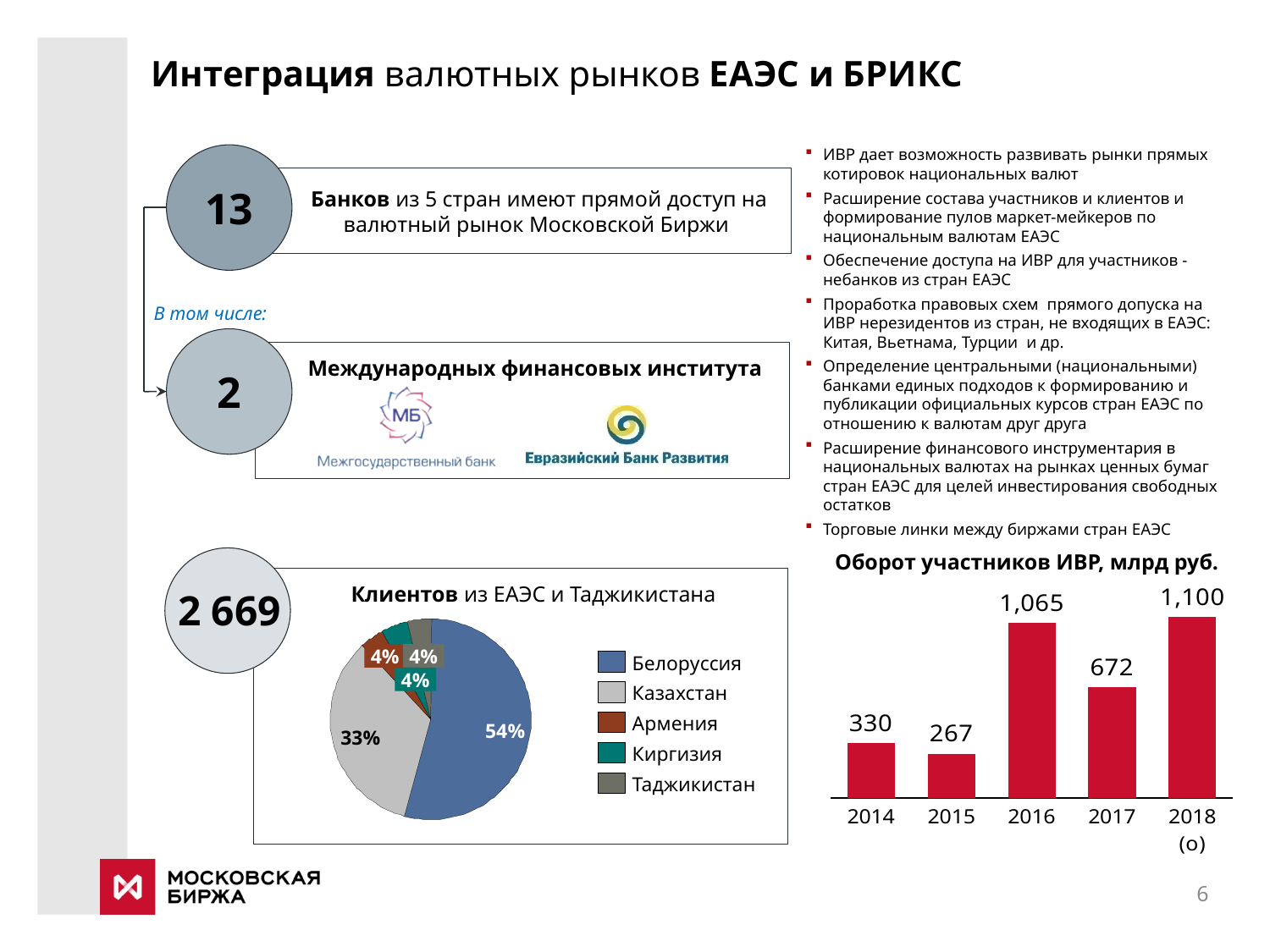
On the bar chart 'Оборот участников ИВР, млрд руб.', what is the value for 2016? 1,065 On the bar chart 'Оборот участников ИВР, млрд руб.', what is the value for 2015? 267 On the bar chart 'Оборот участников ИВР, млрд руб.', which year has the lowest value? 2015 On the bar chart 'Оборот участников ИВР, млрд руб.', what is the difference between the values for 2018 (о) and 2017? 428 How many countries are listed in the legend of the pie chart 'Клиентов из ЕАЭС и Таджикистана'? 5 On the bar chart 'Оборот участников ИВР, млрд руб.', which year has the highest value? 2018 (о) On the bar chart 'Оборот участников ИВР, млрд руб.', which is larger, the value for 2014 or the value for 2015? 2014 On the pie chart 'Клиентов из ЕАЭС и Таджикистана', which country has the largest slice? Белоруссия On the pie chart 'Клиентов из ЕАЭС и Таджикистана', what share does Белоруссия have? 54% How many years are shown on the bar chart 'Оборот участников ИВР, млрд руб.'? 5 What kind of chart is 'Оборот участников ИВР, млрд руб.'? bar chart On the pie chart 'Клиентов из ЕАЭС и Таджикистана', what share does Казахстан have? 33%